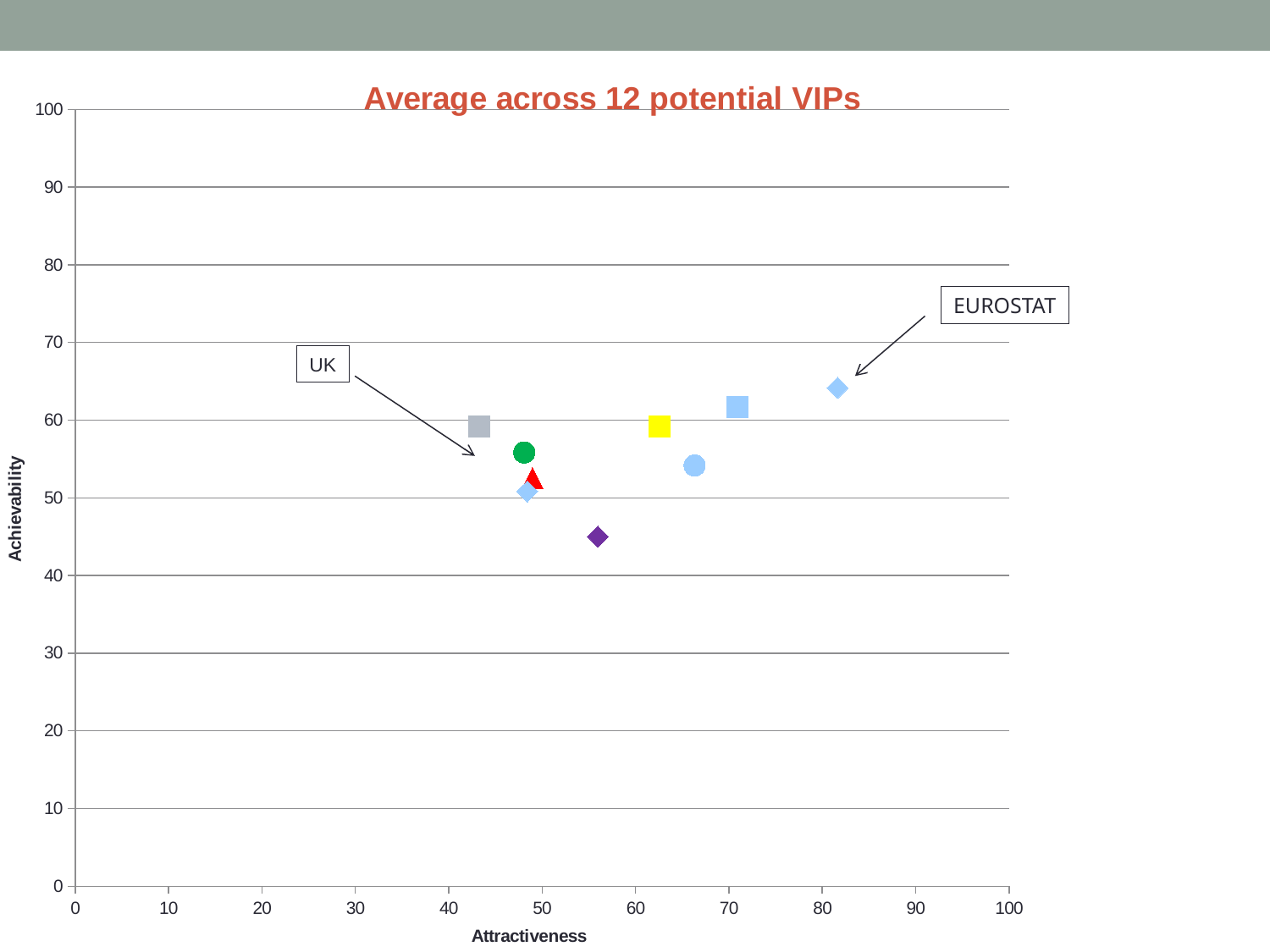
Is the Achievability value for EUROSTAT greater or less than 60? greater What kind of chart is shown on the slide? scatter chart Of the two labelled points, which has the highest Attractiveness? EUROSTAT Is the Attractiveness value for UK greater or less than 50? less What is the label of the horizontal axis? Attractiveness Is the Achievability value for UK greater or less than 50? greater Which has the higher Achievability, UK or EUROSTAT? EUROSTAT Which has the higher Attractiveness, UK or EUROSTAT? EUROSTAT What is the title of the chart? Average across 12 potential VIPs